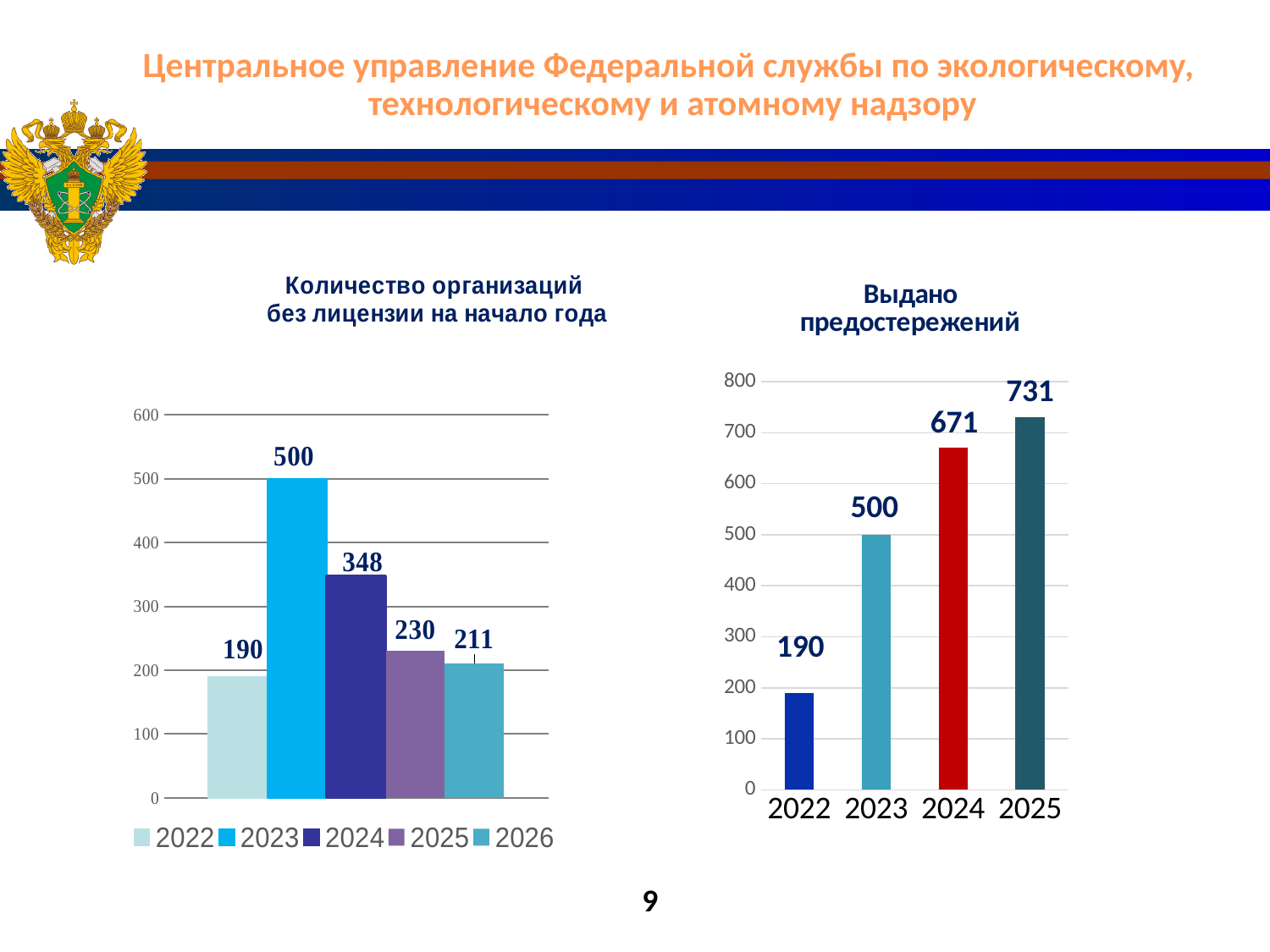
In the chart 'Выдано предостережений', do the values rise or fall from 2022 to 2025? rise In the chart 'Выдано предостережений', how many years are shown on the x axis? 4 In the chart 'Количество организаций без лицензии на начало года', what is the value for 2026? 211 In the chart 'Количество организаций без лицензии на начало года', what is the value for 2024? 348 In the chart 'Выдано предостережений', what is the difference between the values for 2025 and 2024? 60 What kind of chart is 'Выдано предостережений'? bar chart In the chart 'Количество организаций без лицензии на начало года', how many entries does the legend list? 5 In the chart 'Количество организаций без лицензии на начало года', which year has the lowest value? 2022 In the chart 'Выдано предостережений', which year has the lowest value? 2022 In the chart 'Количество организаций без лицензии на начало года', which year has the highest value? 2023 In the chart 'Количество организаций без лицензии на начало года', what is the difference between the values for 2023 and 2024? 152 In the chart 'Выдано предостережений', what is the value for 2025? 731